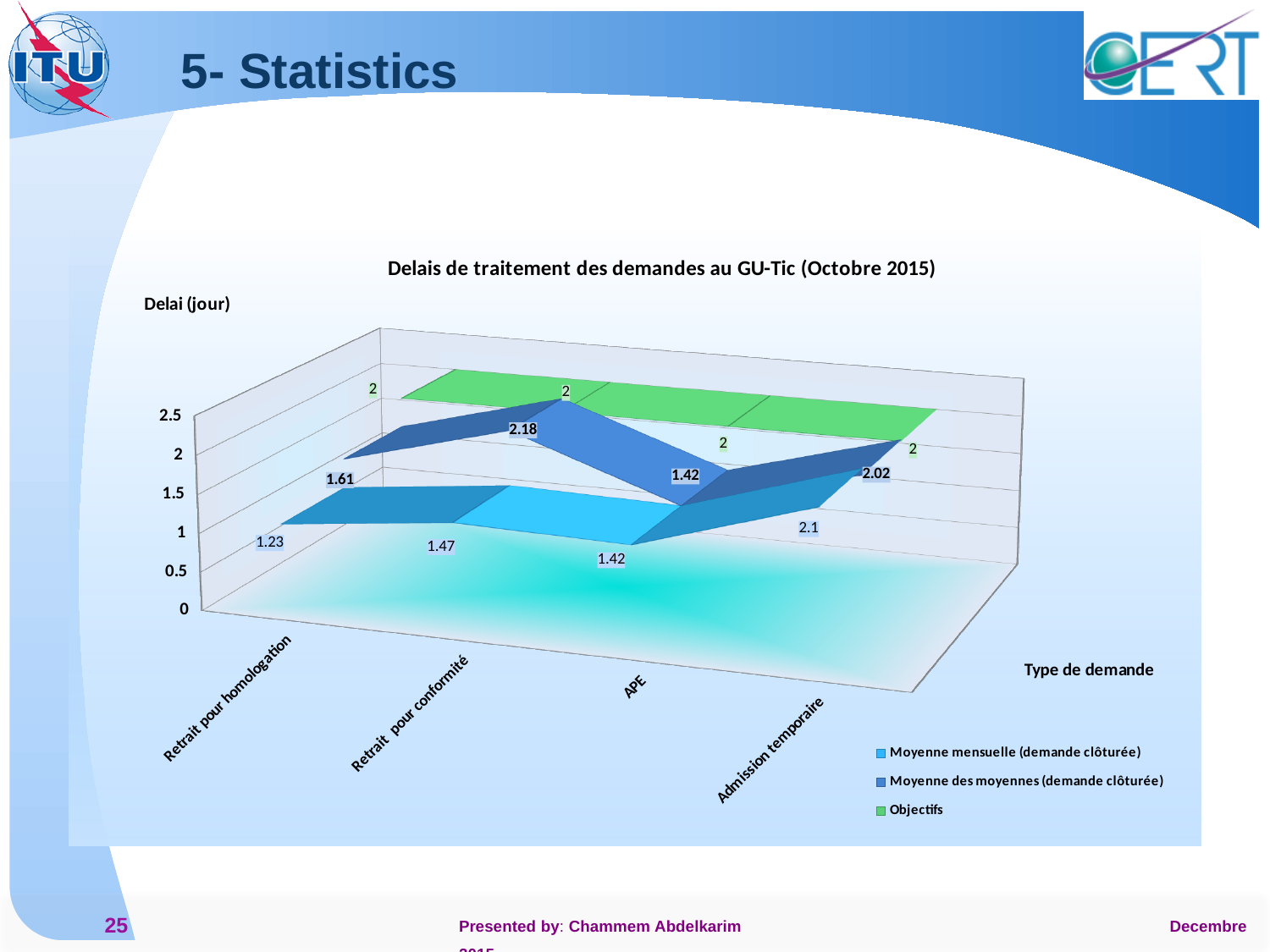
How many types of demande (categories) are shown on the x axis? 4 What is the Moyenne mensuelle (demande clôturée) value for Retrait pour homologation? 1.23 Which is larger for Admission temporaire: the Moyenne mensuelle (demande clôturée) or the Objectifs value? Moyenne mensuelle (demande clôturée) Which type of demande has the highest Moyenne mensuelle (demande clôturée) value? Admission temporaire What is the Moyenne mensuelle (demande clôturée) value for Admission temporaire? 2.1 How many series does the legend list? 3 What is the title of the chart? Delais de traitement des demandes au GU-Tic (Octobre 2015) What kind of chart is shown on the slide? 3D line chart What is the Objectifs value for APE? 2 What is the difference between the Moyenne des moyennes and the Moyenne mensuelle for Retrait pour conformité? 0.71 Which type of demande has the lowest Moyenne mensuelle (demande clôturée) value? Retrait pour homologation What is the Moyenne des moyennes (demande clôturée) value for Retrait pour conformité? 2.18